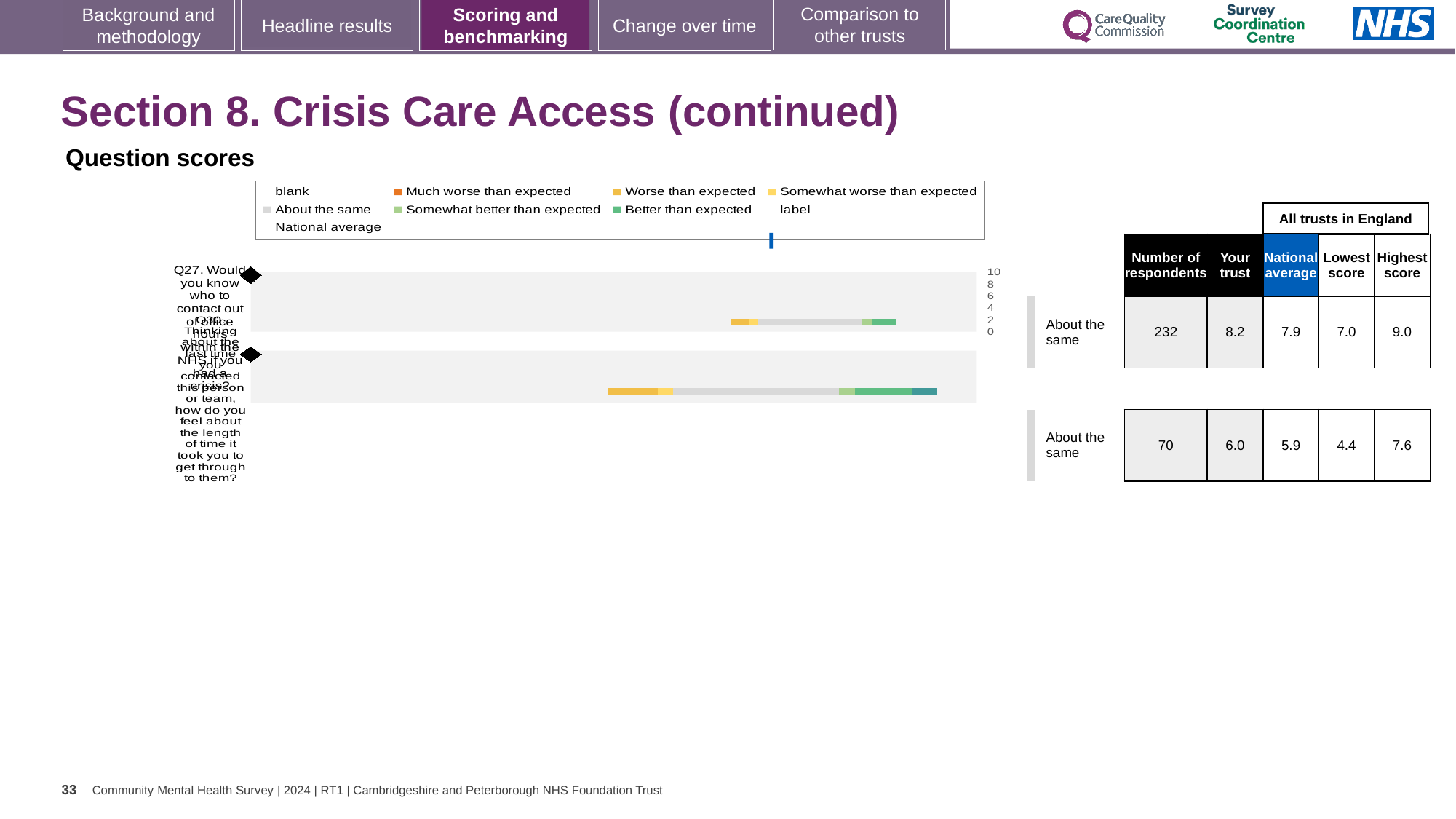
What type of chart is used to show the question scores on this slide? bar chart How many respondents answered Q30? 70 What is the highest score among all trusts in England for Q30? 7.6 What is the national average score for Q30 (how do you feel about the length of time it took you to get through to them?)? 5.9 What is the difference between the highest score and the lowest score for Q27? 2.0 What benchmark category is shown for Q27? About the same What is the 'Your trust' score for Q27 (Would you know who to contact out of office hours within the NHS if you had a crisis?)? 8.2 Which question has the higher 'Your trust' score, Q27 or Q30? Q27 What colour does the legend use for 'Better than expected'? green By how much does the trust's score for Q27 exceed the national average? 0.3 Is the 'Your trust' score for Q30 greater or less than 8? less How many questions (bars) are plotted in the question scores chart? 2